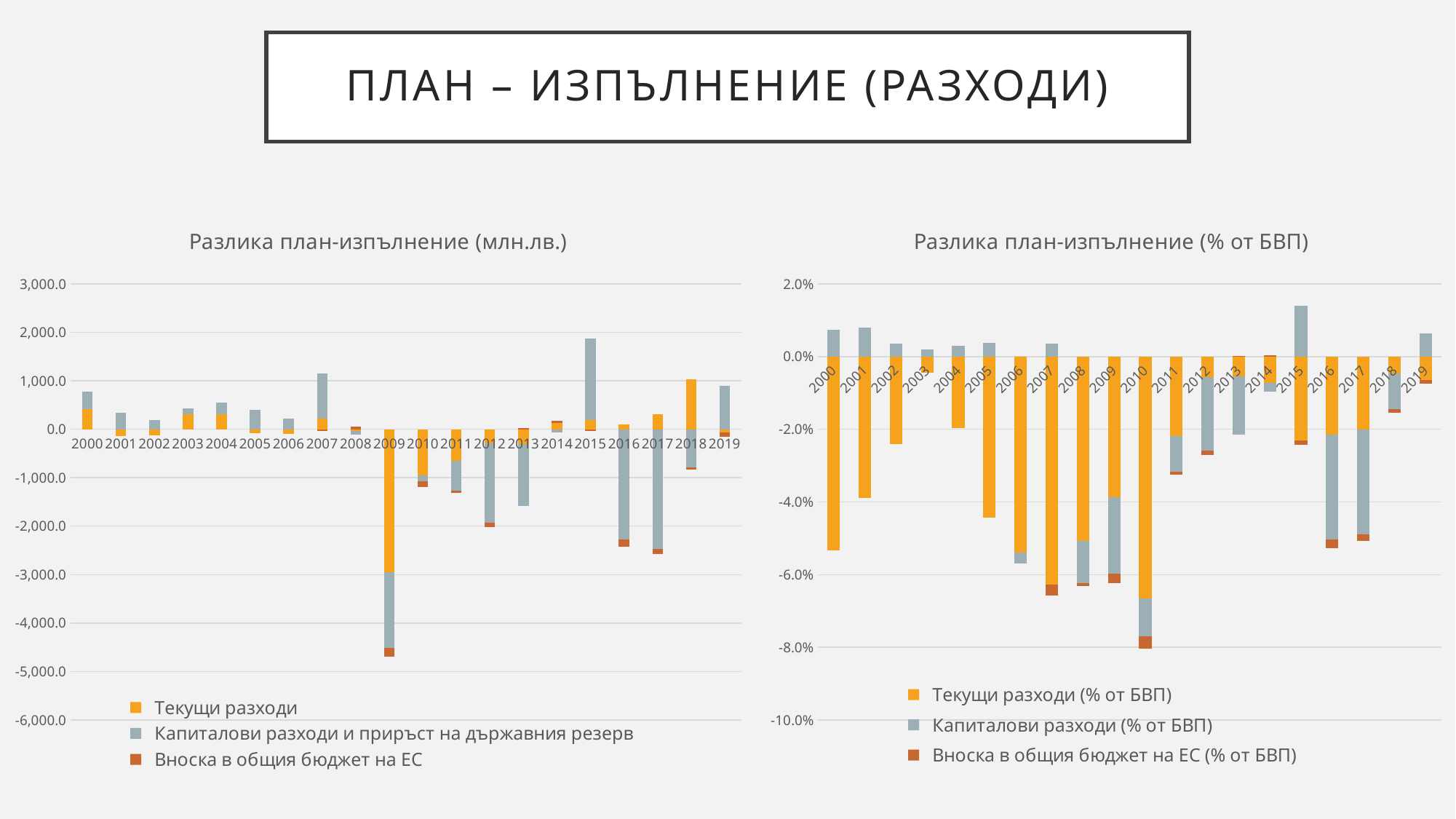
What kind of chart is the left chart titled "Разлика план-изпълнение (млн.лв.)"? Stacked bar chart What is the title of the right chart on the slide? Разлика план-изпълнение (% от БВП) In the right chart "Разлика план-изпълнение (% от БВП)", which year has the bar extending furthest below zero? 2010 How many series does the legend of the right chart "Разлика план-изпълнение (% от БВП)" list? 3 In the right chart "Разлика план-изпълнение (% от БВП)", is the value for Текущи разходи (% от БВП) in 2010 greater or less than -6.0%? less In the left chart "Разлика план-изпълнение (млн.лв.)", is the value for Текущи разходи in 2009 greater or less than -2,000.0? less In the left chart "Разлика план-изпълнение (млн.лв.)", which year's bar extends further below zero, 2009 or 2010? 2009 How many years are shown on the x axis of the left chart "Разлика план-изпълнение (млн.лв.)"? 20 In the left chart "Разлика план-изпълнение (млн.лв.)", which year has the bar extending furthest below zero? 2009 In the left chart "Разлика план-изпълнение (млн.лв.)", which legend entry is shown in orange? Текущи разходи In the left chart "Разлика план-изпълнение (млн.лв.)", is the top of the stacked bar for 2015 greater or less than 1,000.0? greater